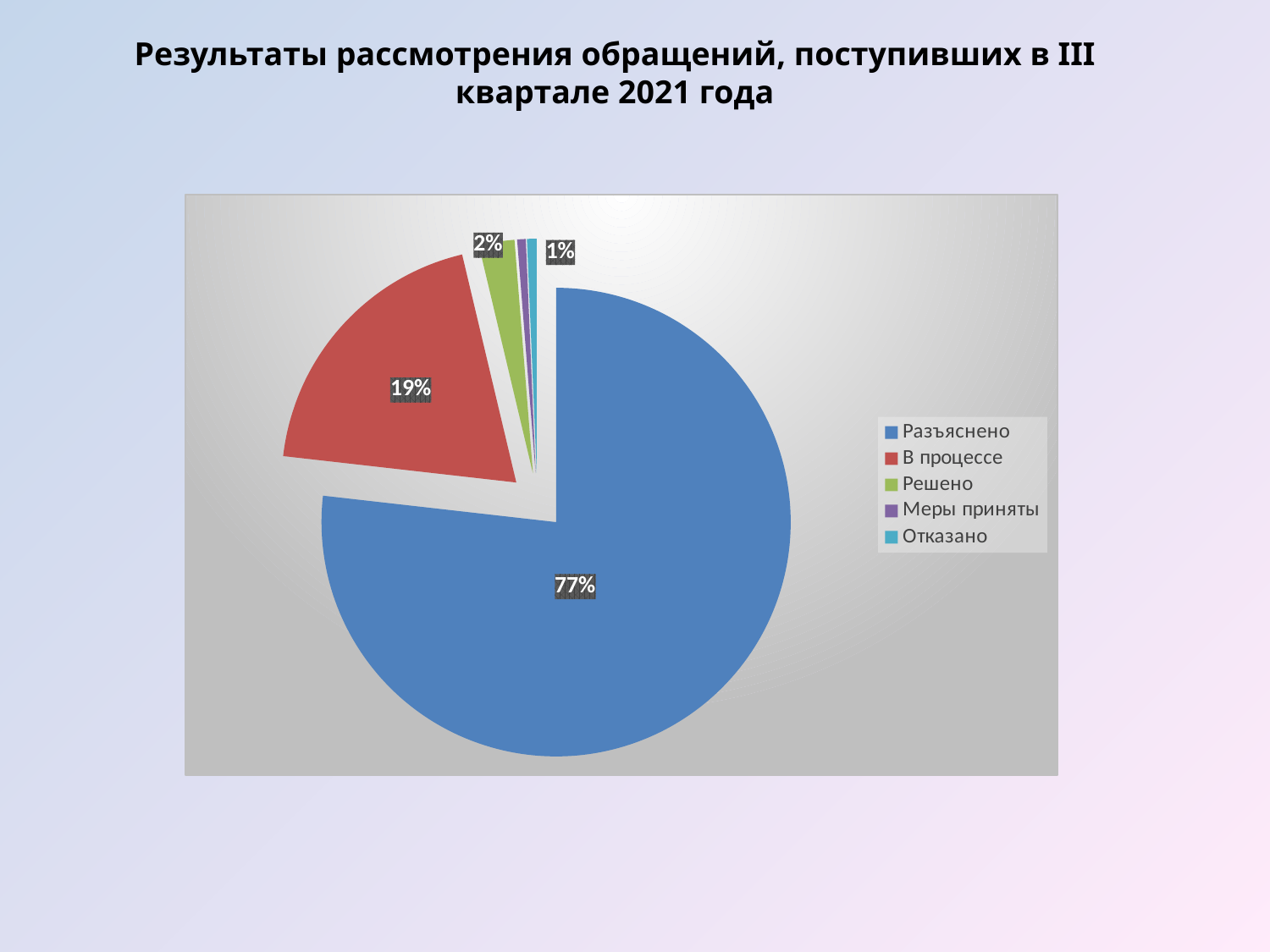
What is the title of the slide? Результаты рассмотрения обращений, поступивших в III квартале 2021 года How many categories does the legend list? 5 Which category has the largest slice of the pie? Разъяснено What share of the pie is labelled for Разъяснено? 77% What percentage is shown for Решено? 2% What colour is the slice for Разъяснено? Blue What percentage is shown for В процессе? 19% By how many percentage points does Разъяснено exceed В процессе? 58 percentage points What type of chart is shown on the slide? Pie chart Which is larger, the slice for Разъяснено or the slice for В процессе? Разъяснено Which is larger, the slice for В процессе or the slice for Решено? В процессе